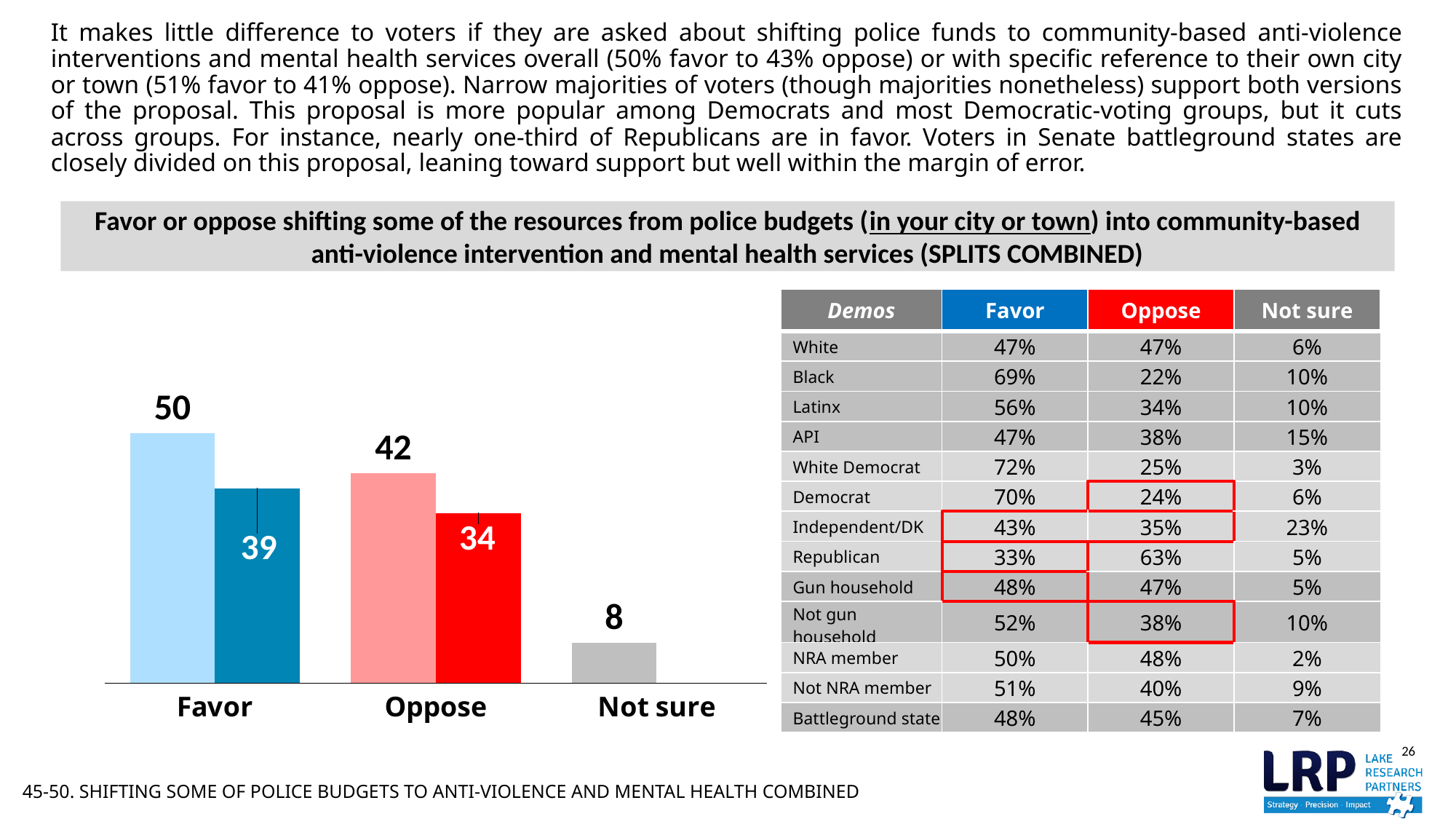
How many categories are shown on the x axis of the bar chart? 3 Which category has the highest value in the bar chart? Favor Which category has the lowest value in the bar chart? Not sure Which is larger, the darker blue Favor bar or the bright red Oppose bar? the darker blue Favor bar What is the difference between the tallest Favor bar (50) and the tallest Oppose bar (42)? 8 What type of chart is shown on the left of the slide? bar chart What colour is the Not sure bar? grey What is the value of the tallest bar in the Favor group? 50 What is the value of the bright red bar in the Oppose group? 34 What is the value of the tallest bar in the Oppose group? 42 What is the value of the darker blue bar in the Favor group? 39 What is the value shown for Not sure? 8